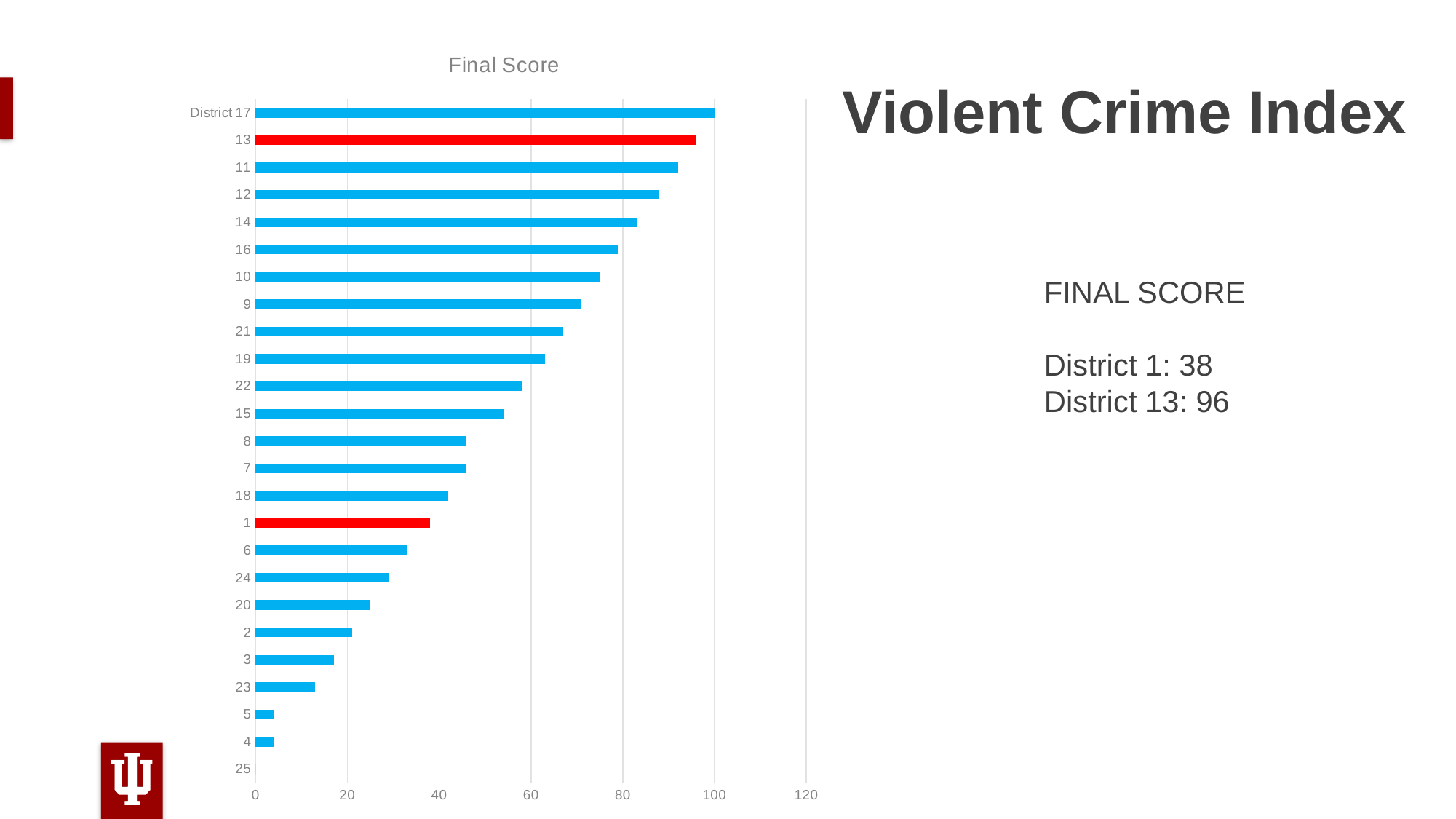
What is the final score for District 13? 96 What kind of chart is shown on the slide? bar chart What is the difference between the final scores of District 13 and District 1? 58 What is the final score for District 17? 100 Which district has the highest final score? District 17 Is the final score for District 6 greater or less than 40? less Which has a higher final score, District 14 or District 16? District 14 Which bars are coloured red on the chart? District 13 and District 1 What is the final score for District 1? 38 Is the final score for District 11 greater or less than 80? greater What is the title of the chart? Final Score How many districts are listed on the chart's vertical axis? 25